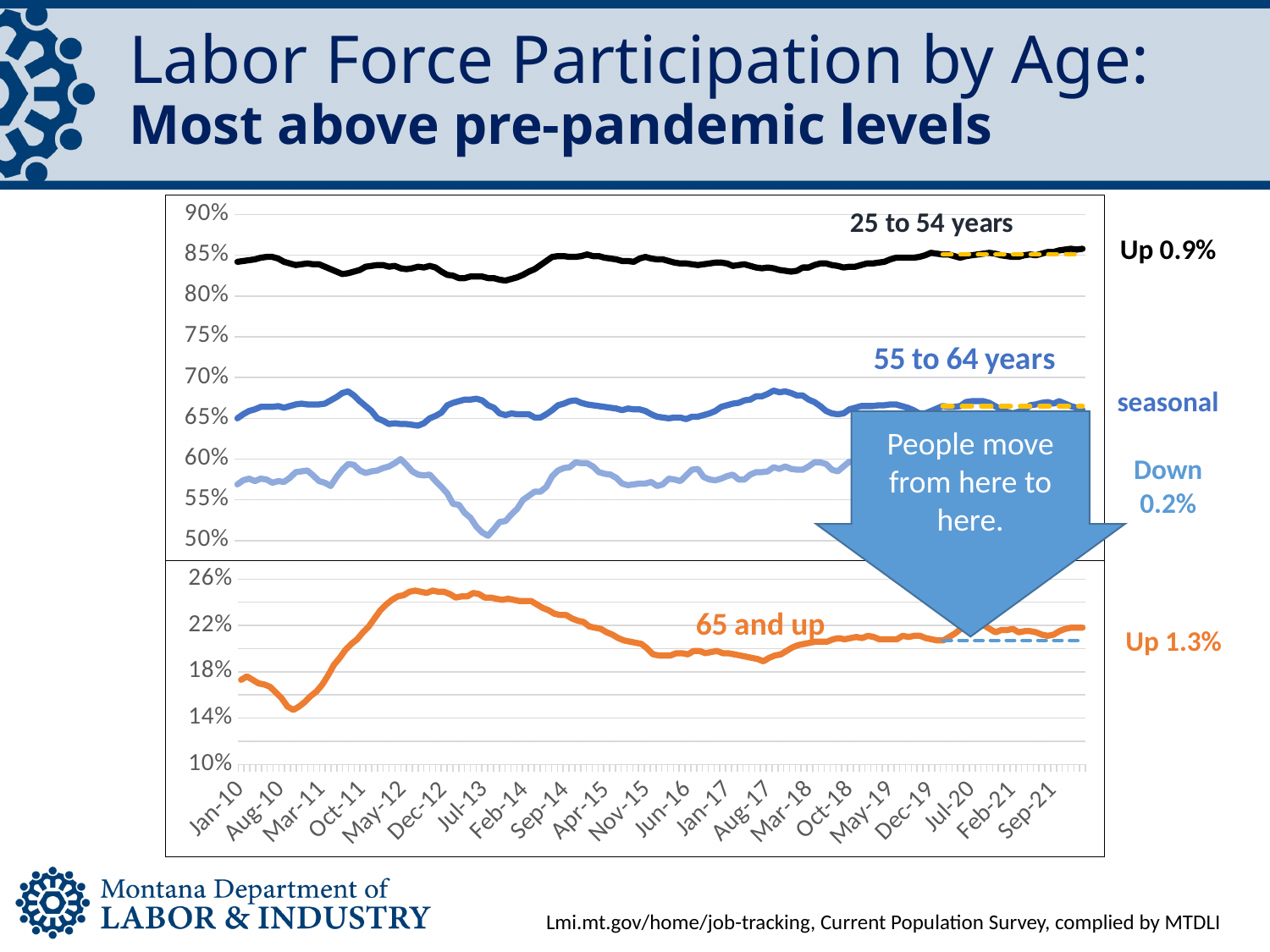
Between Aug-10 and May-12, does the 65 and up line rise or fall? rise Which age group has the lowest labor force participation rate across the whole period? 65 and up What change is annotated next to the 25 to 54 years line at the right of the chart? Up 0.9% What change is annotated next to the 65 and up line at the right of the chart? Up 1.3% Is the value for 25 to 54 years in Feb-14 greater or less than 85%? less What kind of chart is shown on the slide? line chart Is the value for 55 to 64 years in Oct-11 greater or less than 65%? greater Is the value for 65 and up in Mar-11 greater or less than 18%? less Which age group has the highest labor force participation rate across the whole period? 25 to 54 years In Sep-21, which is larger: the value for 55 to 64 years or the value for 65 and up? 55 to 64 years